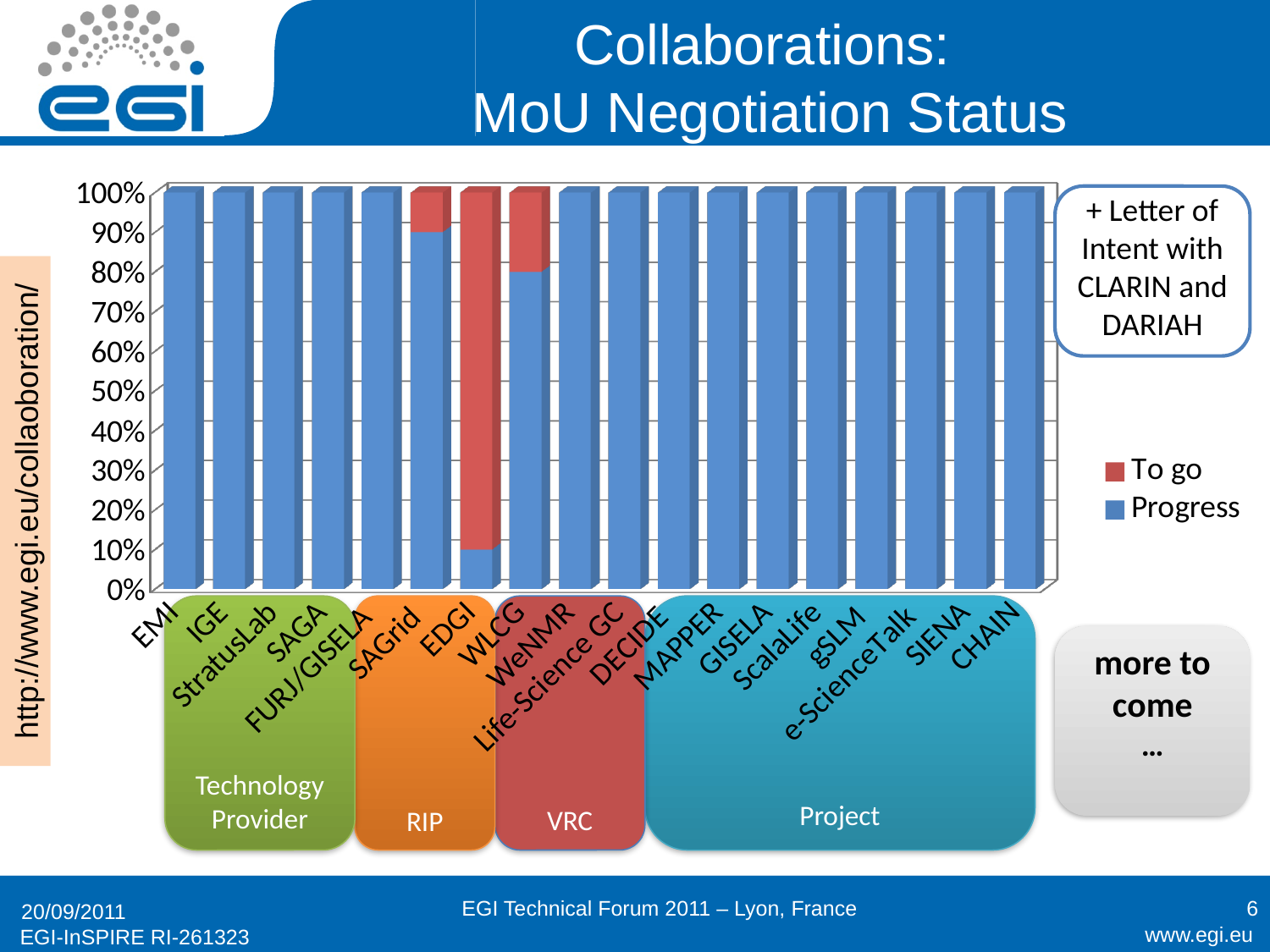
What is the Progress value for EMI? 100% How many series does the chart legend list? 2 What is the Progress value for EDGI? 10% What is the Progress value for WeNMR? 100% Is the Progress value for WeNMR greater or less than 50%? greater What kind of chart is shown on the slide? stacked bar chart Which collaboration has the lowest Progress value in the chart? EDGI What are the two series named in the chart legend? To go and Progress Which has a larger Progress value, EDGI or WeNMR? WeNMR What is the Progress value for WLCG? 80% How many collaborations (categories) are plotted along the x axis of the chart? 18 Is the Progress value for WLCG greater or less than 50%? greater